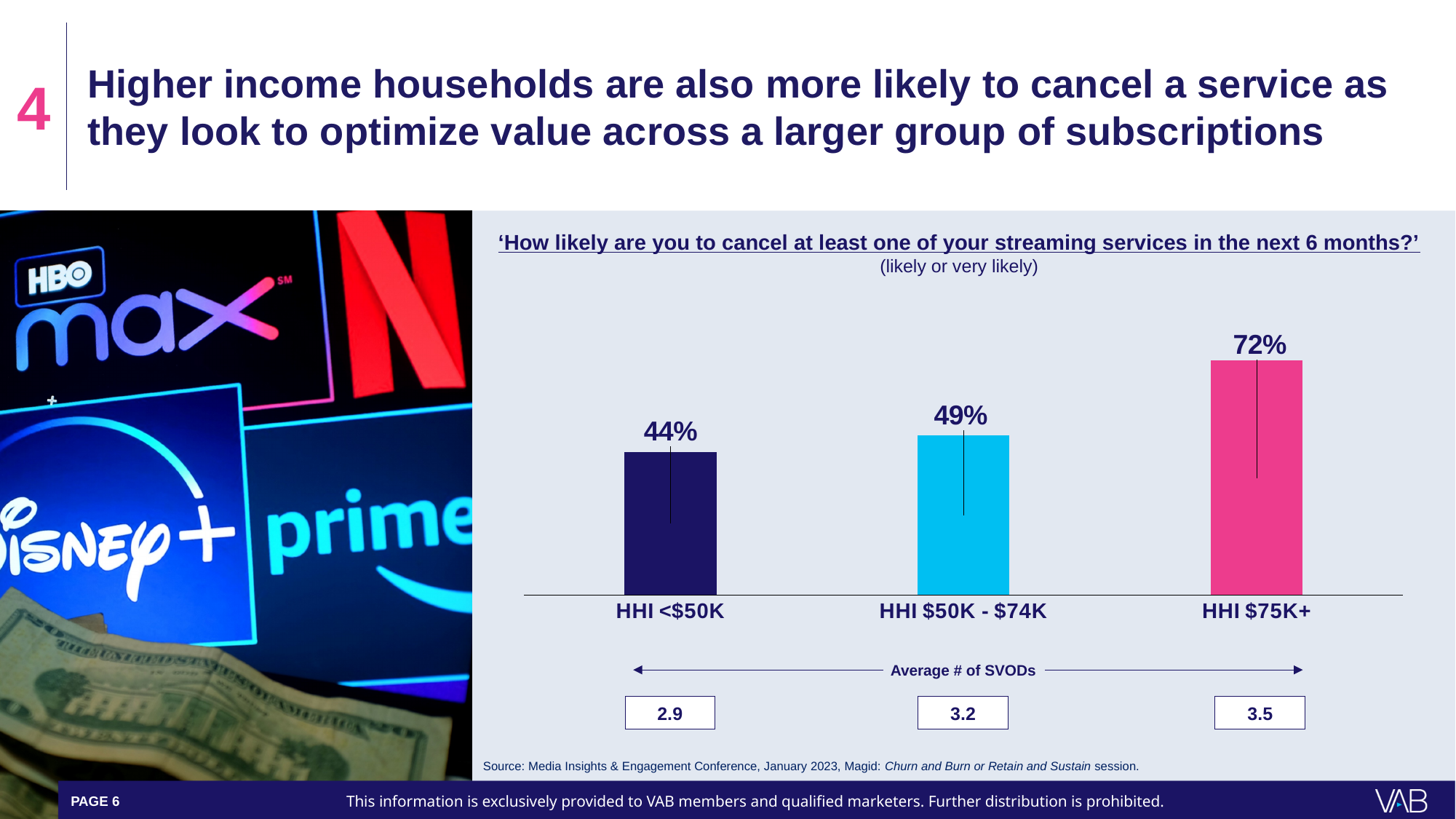
What is the difference in percentage points between the HHI $75K+ and HHI <$50K groups? 28 How many household income categories are shown in the chart? 3 Do the values rise or fall as household income increases from left to right? Rise Which household income group has the highest share likely to cancel a streaming service? HHI $75K+ Which household income group has the lowest share likely to cancel a streaming service? HHI <$50K What is the average number of SVODs for the HHI $75K+ group? 3.5 Which group is more likely to cancel a streaming service: HHI $50K - $74K or HHI $75K+? HHI $75K+ What is the difference in percentage points between the HHI $50K - $74K and HHI <$50K groups? 5 What percentage of HHI $75K+ households are likely or very likely to cancel at least one streaming service in the next 6 months? 72% What percentage of HHI $50K - $74K households are likely or very likely to cancel at least one streaming service in the next 6 months? 49% What percentage of HHI <$50K households are likely or very likely to cancel at least one streaming service in the next 6 months? 44% What kind of chart is used to show the likelihood of cancelling a streaming service? Bar chart